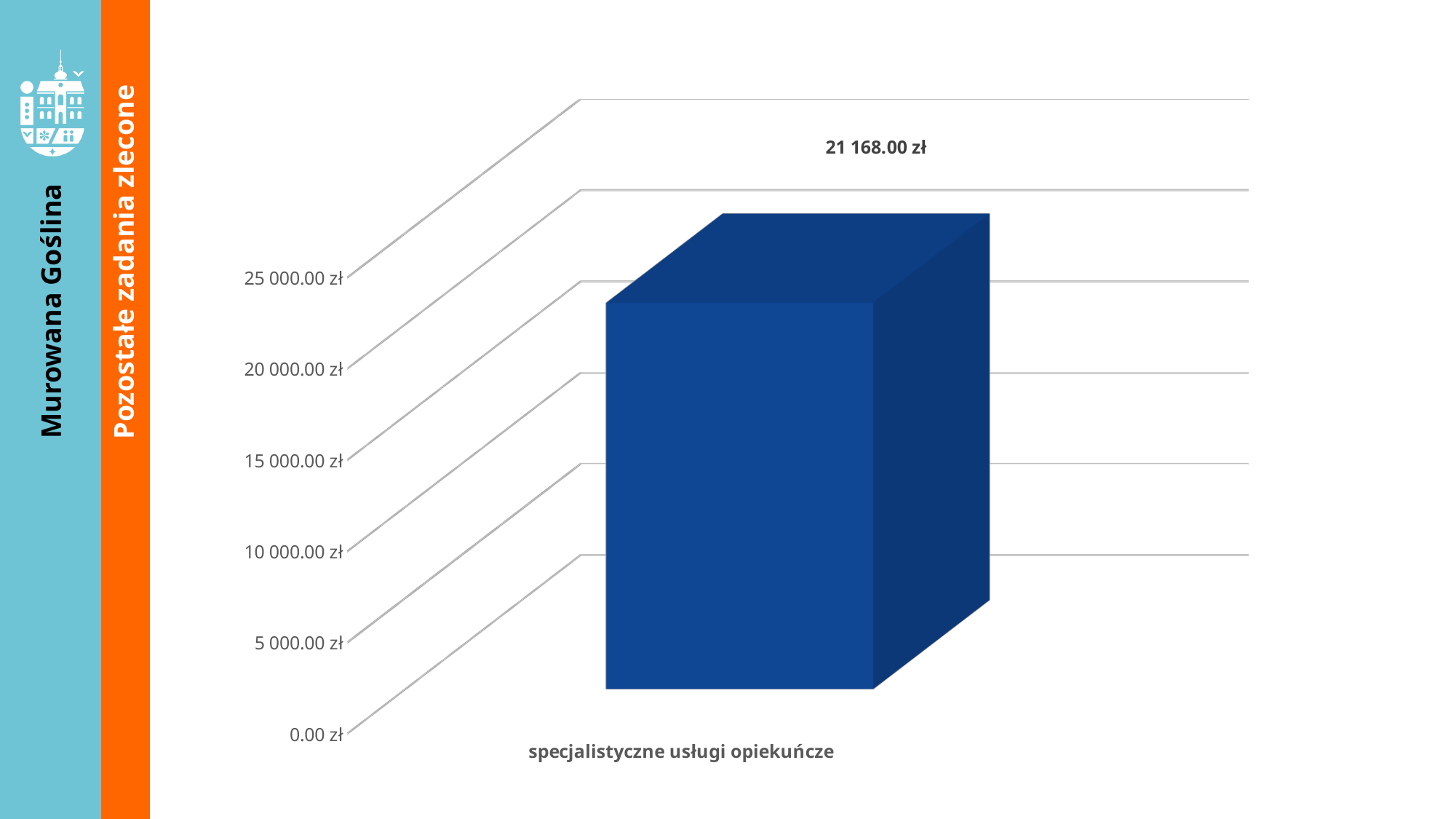
What is the highest value shown on the vertical axis? 25 000.00 zł What is the label of the only category on the x axis? specjalistyczne usługi opiekuńcze Is the value for specjalistyczne usługi opiekuńcze greater or less than 20 000.00 zł? greater What is the value for specjalistyczne usługi opiekuńcze? 21 168.00 zł Is the value for specjalistyczne usługi opiekuńcze greater or less than 25 000.00 zł? less What kind of chart is shown on the slide? bar chart How many categories are plotted on the chart? 1